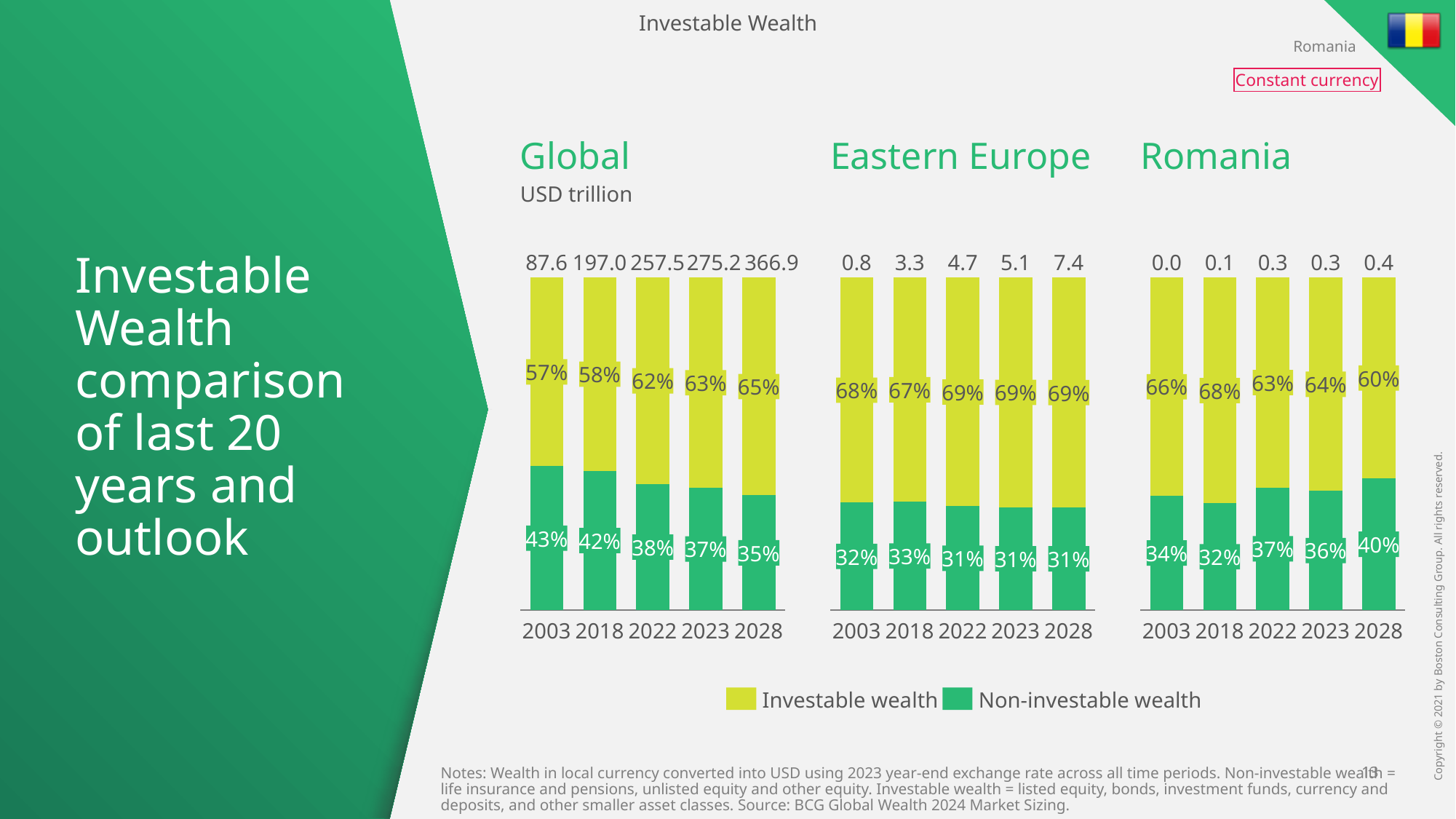
What kind of chart is used for the Global data? Stacked bar chart How many series does the legend list? 2 In the Global chart, what is the difference between the total wealth values for 2028 and 2023? 91.7 In the Global chart, which year has the lowest total wealth value? 2003 How many years are shown on the x axis of the Eastern Europe chart? 5 In the Global chart, what is the total wealth value shown above the 2028 bar? 366.9 In the Global chart, what share of wealth is investable in 2003? 57% In the Eastern Europe chart, which year has the highest total wealth value? 2028 In the Global chart, does the investable wealth share rise or fall from 2003 to 2028? Rise In the Romania chart, what is the investable wealth share in 2028? 60% In the Eastern Europe chart, what is the non-investable wealth share in 2022? 31% In the Romania chart, is the investable wealth share larger in 2018 or in 2028? 2018